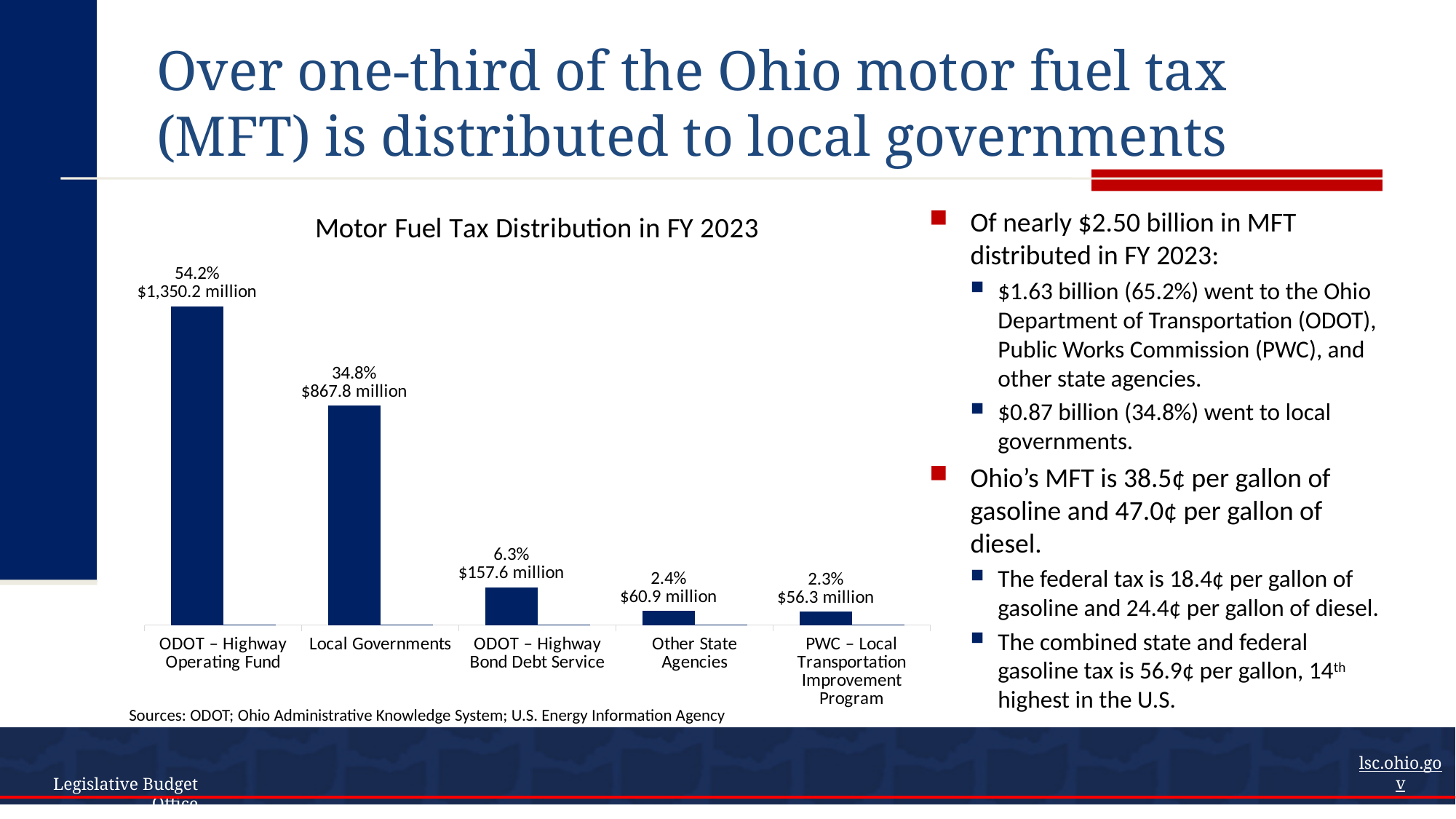
What type of chart is shown on the slide? Bar chart How many categories are shown in the chart? 5 What is the value for ODOT – Highway Operating Fund? $1,350.2 million What is the value for ODOT – Highway Bond Debt Service? $157.6 million Which category received the smallest amount? PWC – Local Transportation Improvement Program What is the value for PWC – Local Transportation Improvement Program? $56.3 million Which is larger, the value for Other State Agencies or ODOT – Highway Bond Debt Service? ODOT – Highway Bond Debt Service What percentage of the motor fuel tax distribution went to Local Governments? 34.8% What is the difference in dollars between ODOT – Highway Operating Fund and Local Governments? $482.4 million What percentage share is shown for Other State Agencies? 2.4% What is the title of the chart? Motor Fuel Tax Distribution in FY 2023 Which category received the largest share of the motor fuel tax distribution? ODOT – Highway Operating Fund